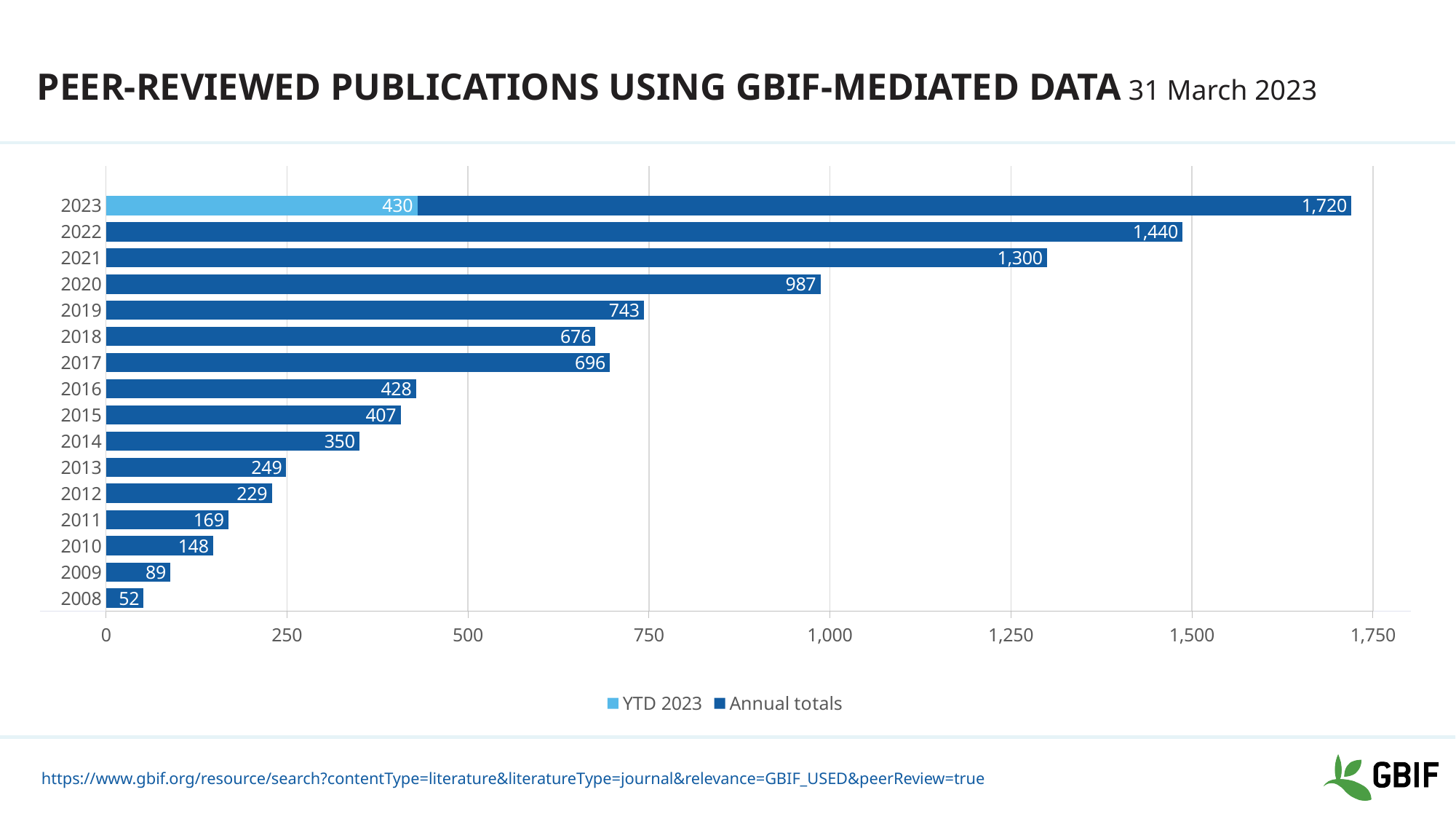
Do the annual totals generally rise or fall from 2008 to 2022? rise What are the two legend entries on the chart? YTD 2023 and Annual totals What is the difference between the values for 2022 and 2021? 140 What is the value labelled for 2016? 428 How many years are shown on the chart? 16 Which year has the lowest number of publications? 2008 Is the value for 2019 greater or less than 750? less What is the annual total of peer-reviewed publications for 2020? 987 What kind of chart is shown on the slide? bar chart What is the YTD 2023 value shown on the 2023 bar? 430 Which is larger, the value for 2017 or the value for 2018? 2017 How many series does the legend list? 2